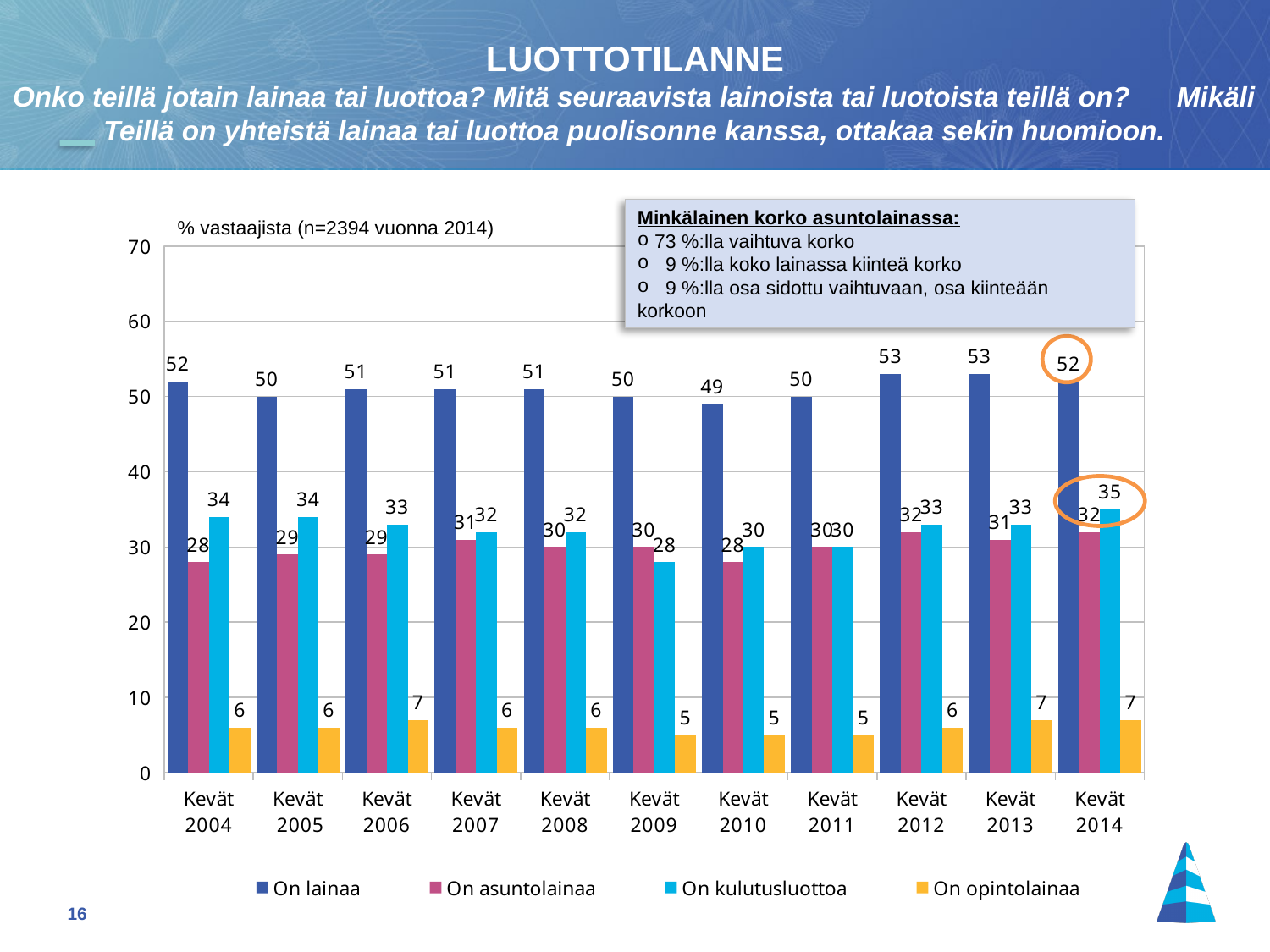
How many years (categories) are shown on the x axis? 11 What is the value for "On opintolainaa" in Kevät 2009? 5 Which is larger in Kevät 2009: "On asuntolainaa" or "On kulutusluottoa"? On asuntolainaa What is the difference between "On lainaa" and "On asuntolainaa" in Kevät 2012? 21 What is the value for "On asuntolainaa" in Kevät 2004? 28 How many series does the legend list? 4 In which year does "On lainaa" reach its lowest value? Kevät 2010 What is the value for "On kulutusluottoa" in Kevät 2014? 35 What kind of chart is shown on the slide? Bar chart Is the value for "On lainaa" in Kevät 2013 greater or less than 50? greater Which series is shown in yellow in the legend? On opintolainaa What is the value for "On lainaa" in Kevät 2014? 52